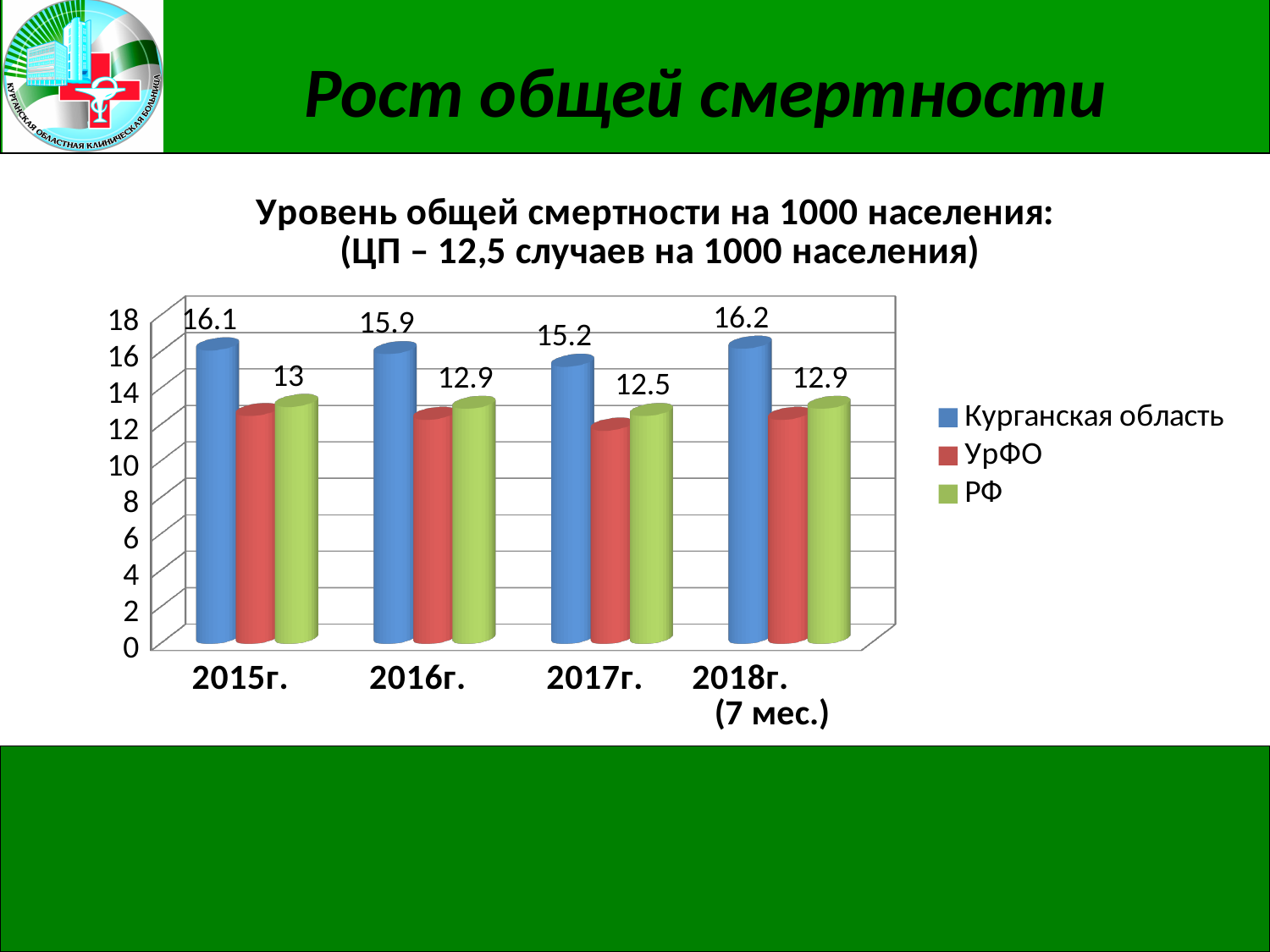
What colour represents РФ in the legend? green What is the difference between the Курганская область value and the РФ value in 2015г.? 3.1 Which is larger in 2016г., the value for Курганская область or the value for РФ? Курганская область What is the value for РФ in 2018г. (7 мес.)? 12.9 In which year is the value for РФ the lowest? 2017г. In which year is the value for Курганская область the highest? 2018г. (7 мес.) What kind of chart is shown on the slide? bar chart How many year categories are shown on the x axis? 4 What is the value for Курганская область in 2017г.? 15.2 Is the value for УрФО in 2015г. greater or less than 10? greater How many series does the legend list? 3 What is the value for Курганская область in 2015г.? 16.1